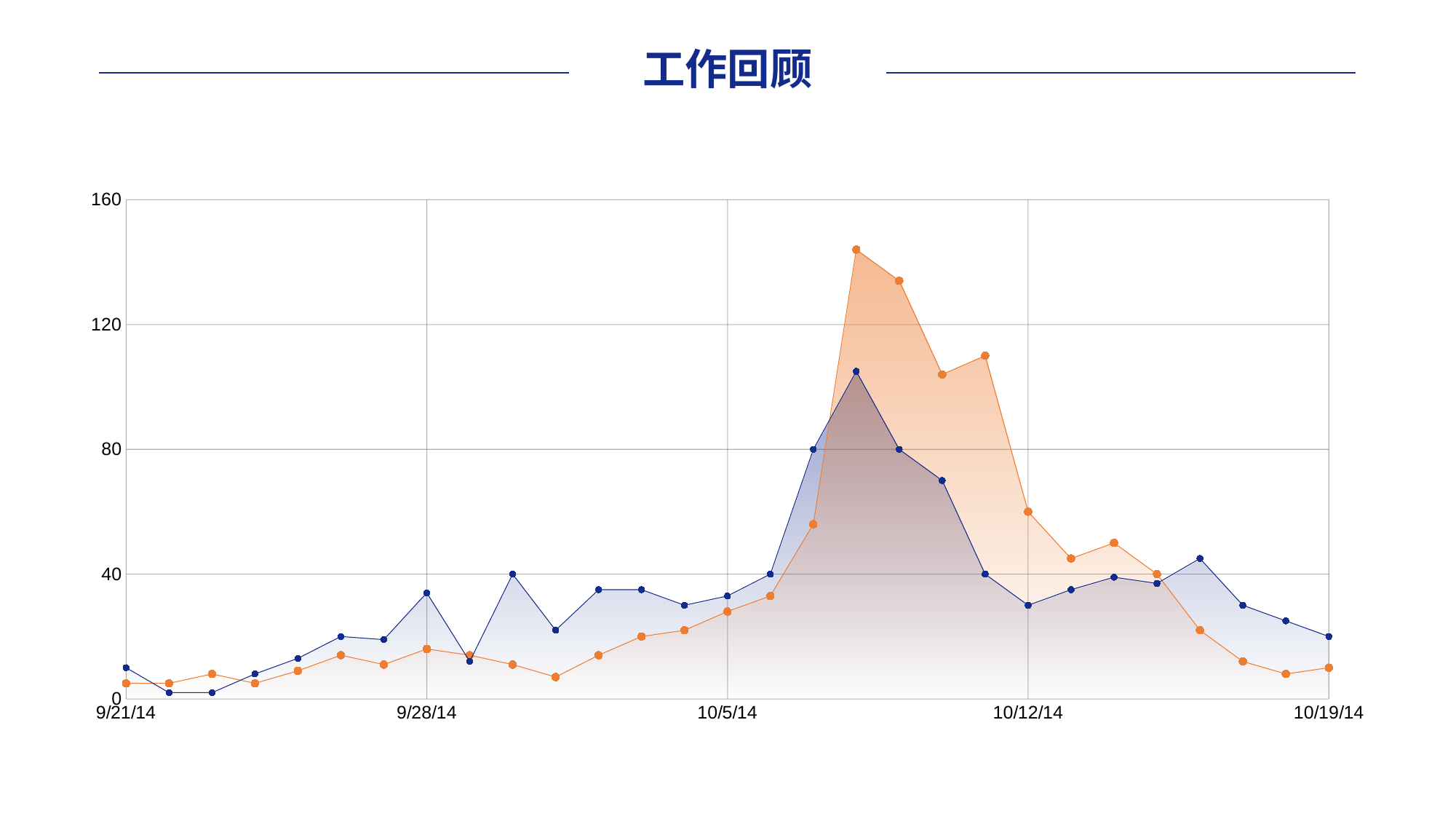
At 10/12/14, which series has the higher value, the blue or the orange? orange What is the title of the slide? 工作回顾 Is the orange series value at 10/12/14 greater or less than 40? greater Is the blue series value at 9/21/14 greater or less than 40? less What kind of chart is shown on the slide? line chart Does the orange series rise or fall overall from 10/12/14 to 10/19/14? fall At 9/28/14, which series has the higher value, the blue or the orange? blue Between which two labeled dates does the highest point of the chart occur? 10/5/14 and 10/12/14 Is the peak value of the blue series greater or less than 80? greater How many lines (series) are plotted on the chart? 2 How many date labels are shown on the x axis? 5